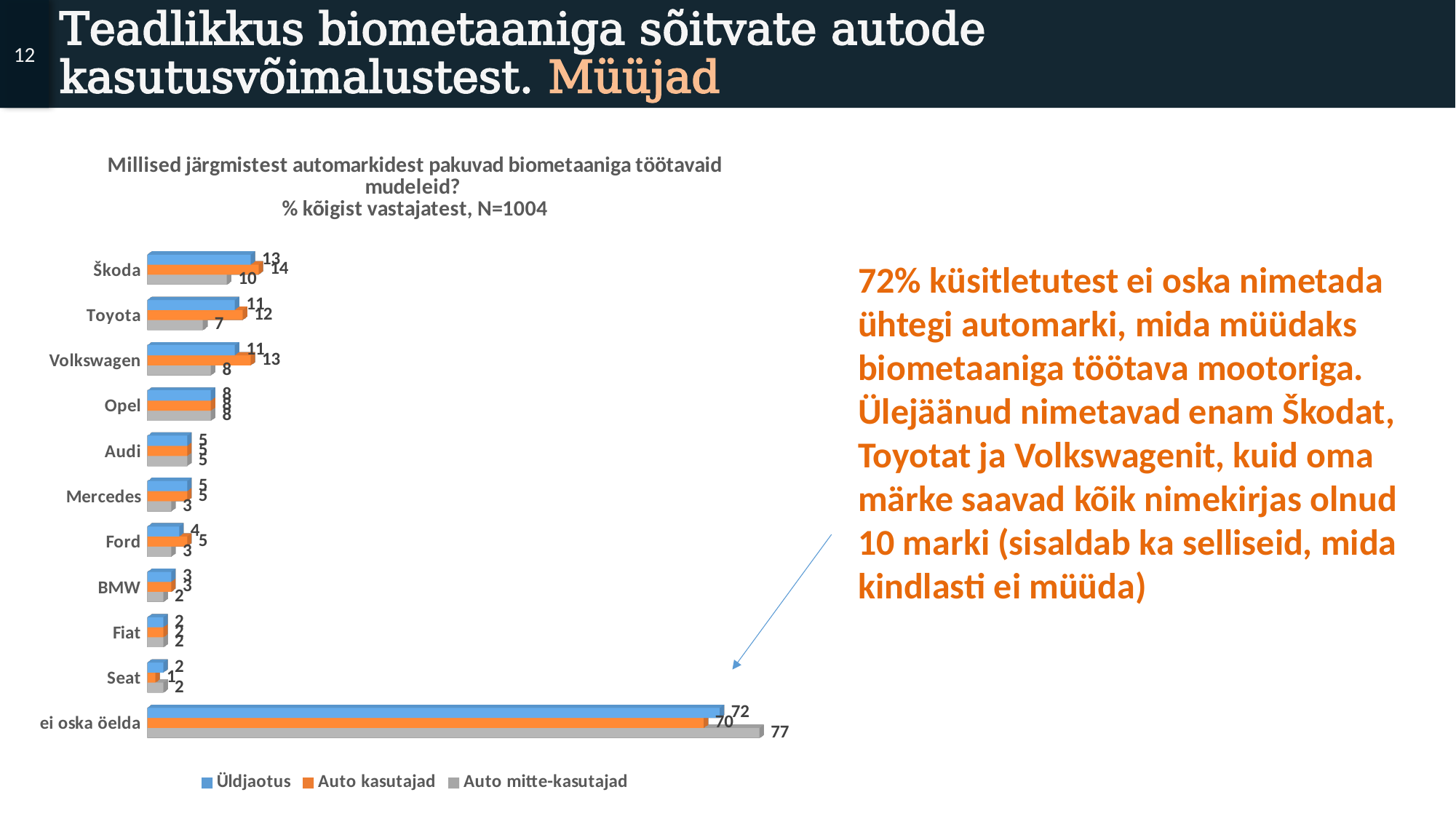
What is the difference between the Auto mitte-kasutajad and Auto kasutajad values for ei oska öelda? 7 How many categories are shown on the chart? 11 What is the Üldjaotus value for Škoda? 13 What is the Auto mitte-kasutajad value for Toyota? 7 How many series does the legend list? 3 What is the Auto kasutajad value for Volkswagen? 13 What is the Auto mitte-kasutajad value for ei oska öelda? 77 What is the sample size (N) stated in the chart title? N=1004 Which category has the highest Üldjaotus value? ei oska öelda Among the car brands (excluding ei oska öelda), which has the lowest Auto kasutajad value? Seat What kind of chart is shown on the slide? Bar chart Which is larger for Škoda: the Auto kasutajad value or the Auto mitte-kasutajad value? Auto kasutajad